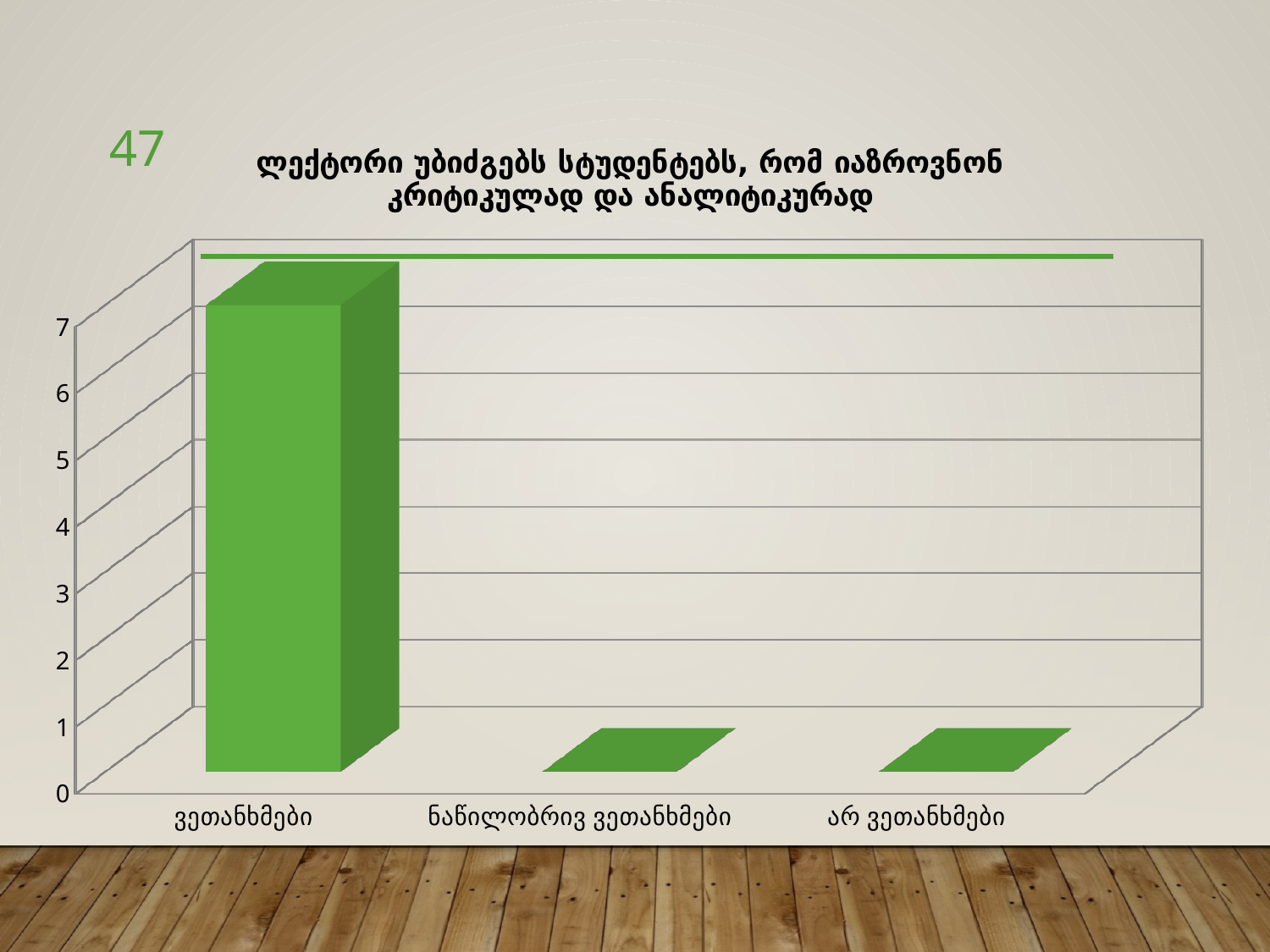
What colour are the bars in the chart? green Is the value for ვეთანხმები greater or less than 5? greater What is the value for არ ვეთანხმები? 0 What kind of chart is shown on the slide? bar chart What is the difference between the value for ვეთანხმები and the value for ნაწილობრივ ვეთანხმები? 7 Is the value for არ ვეთანხმები greater or less than 1? less Do the values rise or fall from the first category to the last along the x axis? fall What is the value for ნაწილობრივ ვეთანხმები? 0 What is the value for ვეთანხმები? 7 How many categories are shown on the x axis of the chart? 3 Which is larger, the value for ვეთანხმები or the value for არ ვეთანხმები? ვეთანხმები Which category has the highest value in the chart? ვეთანხმები